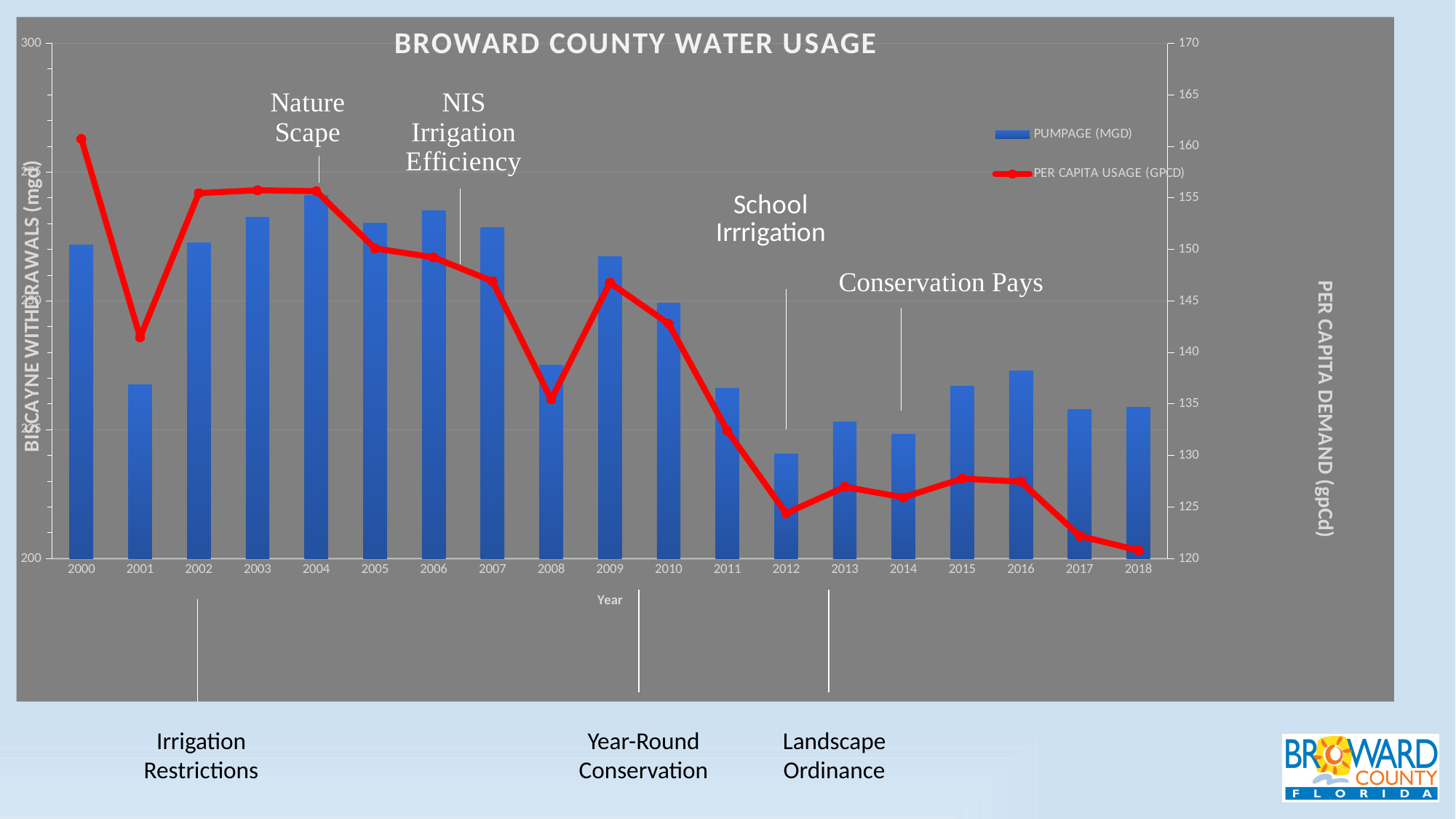
Is the pumpage (MGD) value for 2001 greater or less than 250? less Which series is drawn as a red line? PER CAPITA USAGE (GPCD) What is the title of the chart? BROWARD COUNTY WATER USAGE Is the pumpage (MGD) value for 2004 greater or less than 250? greater How many years are shown along the x axis? 19 Which year has the highest per capita usage (GPCD)? 2000 What type of chart is shown on the slide? Combined bar and line chart Is the per capita usage (GPCD) value for 2012 greater or less than 130? less Which year has the larger pumpage (MGD) bar, 2008 or 2009? 2009 Which year has the lowest pumpage (MGD) bar? 2012 Does per capita usage (GPCD) generally rise or fall from 2000 to 2018? fall How many series does the legend list? 2